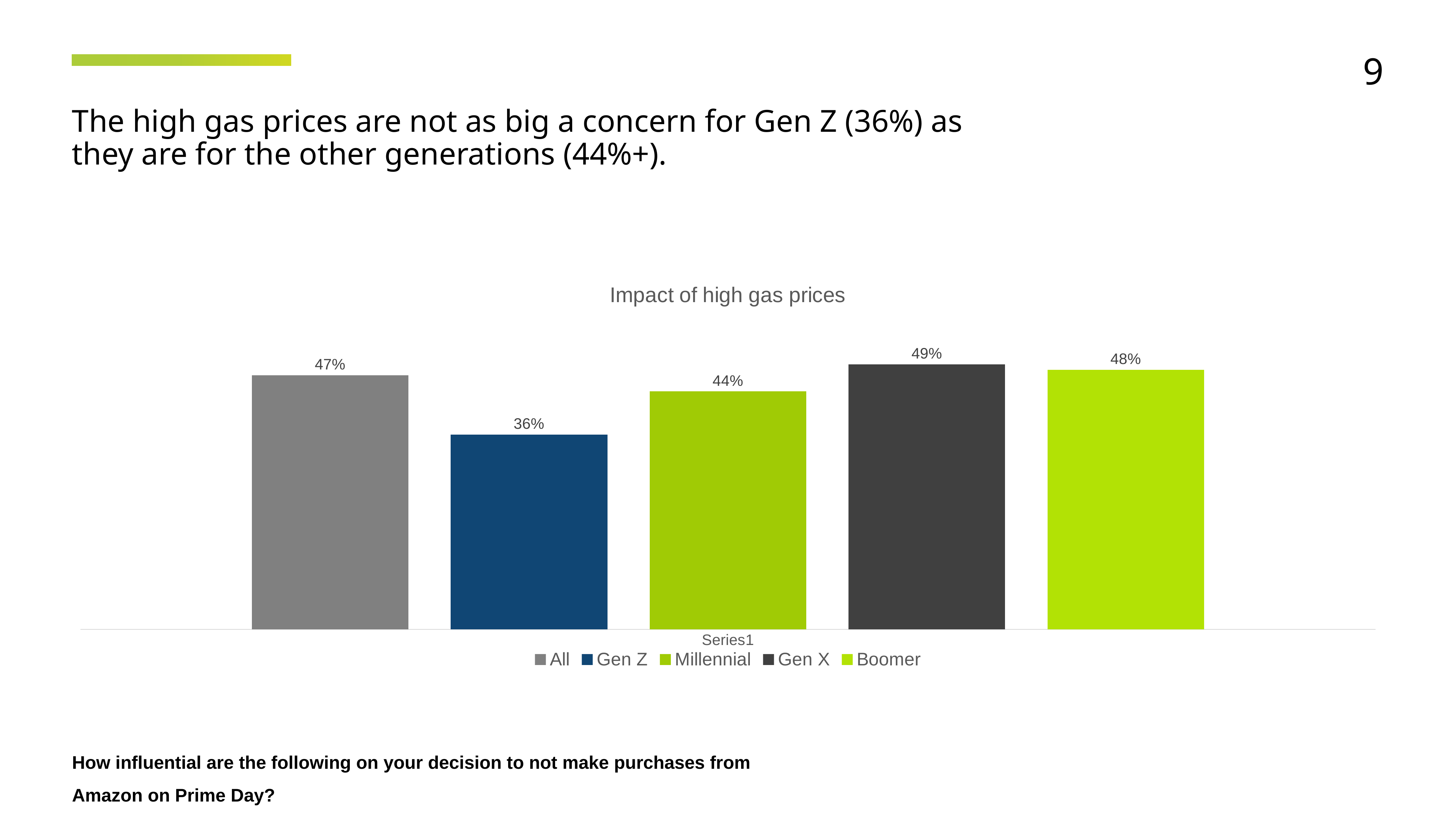
What is the value for Gen Z in the Impact of high gas prices chart? 36% What kind of chart is shown on the slide? Bar chart What is the title of the chart on the slide? Impact of high gas prices What is the value for All in the Impact of high gas prices chart? 47% Which is larger in the Impact of high gas prices chart, the value for Millennial or the value for Gen Z? Millennial What is the difference between the Millennial and Gen Z values in the Impact of high gas prices chart? 8% Which group has the highest value in the Impact of high gas prices chart? Gen X What is the difference between the Gen X and Gen Z values in the Impact of high gas prices chart? 13% How many series does the legend list in the Impact of high gas prices chart? 5 What is the value for Boomer in the Impact of high gas prices chart? 48% Which group has the lowest value in the Impact of high gas prices chart? Gen Z What is the value for Gen X in the Impact of high gas prices chart? 49%